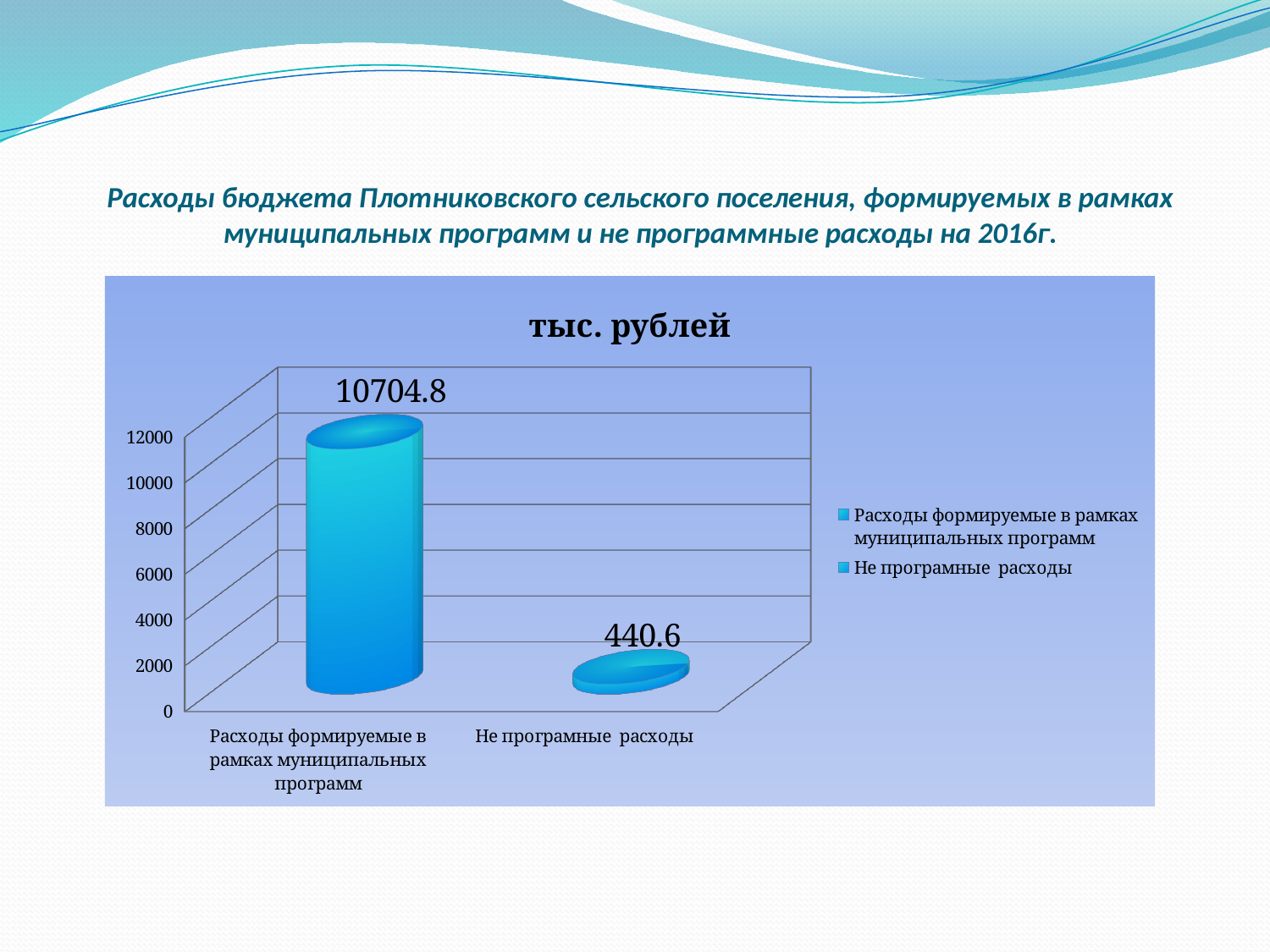
How many categories are shown on the x axis of the chart? 2 Which is larger: the value for "Расходы формируемые в рамках муниципальных программ" or the value for "Не програмные расходы"? Расходы формируемые в рамках муниципальных программ What is the title of the chart? тыс. рублей Is the value for "Расходы формируемые в рамках муниципальных программ" greater or less than 10000? greater What is the value for "Расходы формируемые в рамках муниципальных программ"? 10704.8 Which category has the lowest value? Не програмные расходы What is the difference between the value for "Расходы формируемые в рамках муниципальных программ" and the value for "Не програмные расходы"? 10264.2 Is the value for "Не програмные расходы" greater or less than 2000? less How many entries does the chart's legend list? 2 What is the value for "Не програмные расходы"? 440.6 What kind of chart is shown on the slide? bar chart Which category has the highest value? Расходы формируемые в рамках муниципальных программ